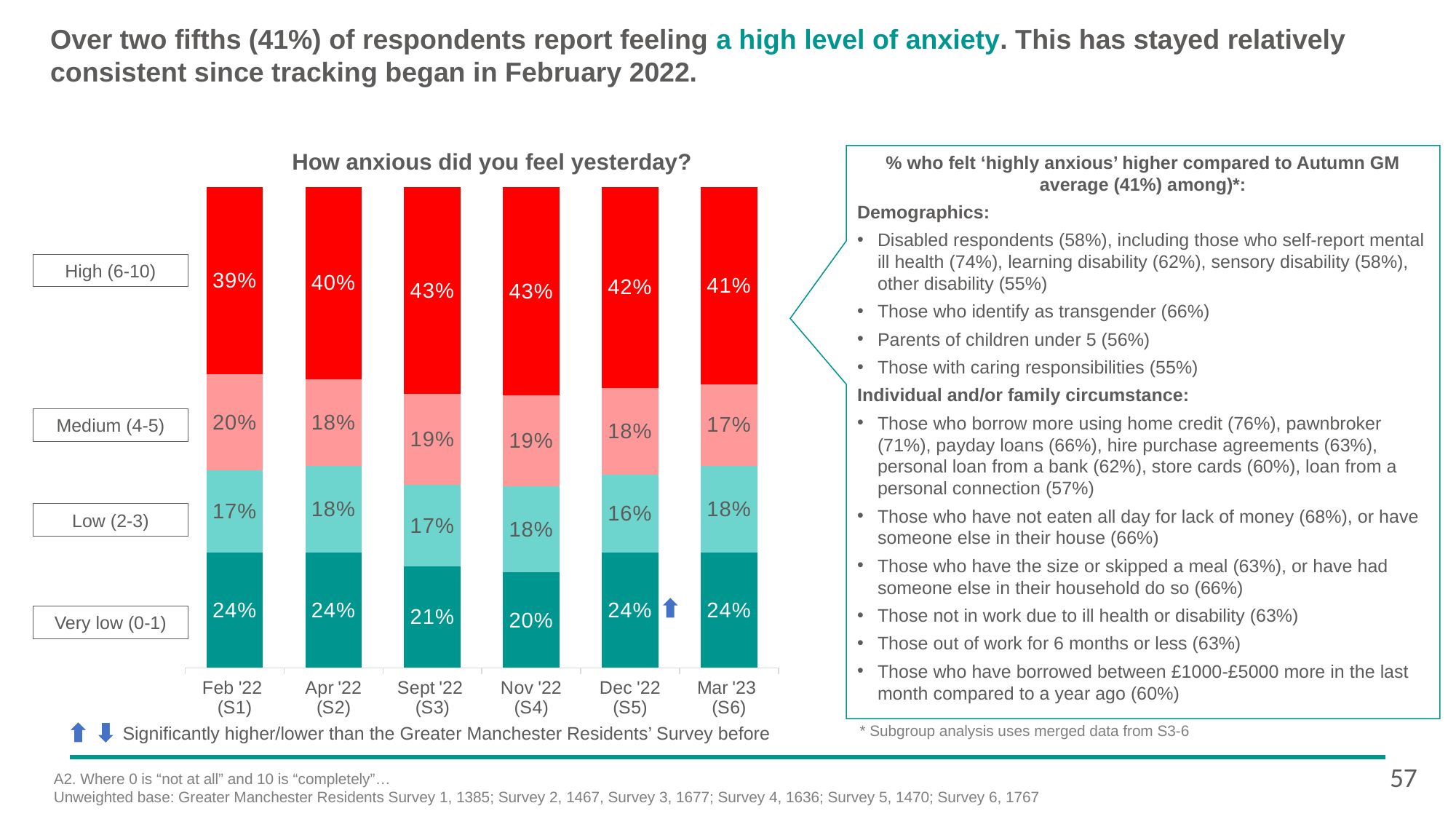
How many anxiety level categories (series) are stacked in each bar? 4 How many survey waves are shown on the x axis of the chart? 6 What type of chart is used to show how anxious respondents felt yesterday? Stacked bar chart What is the Medium (4-5) value for Feb '22 (S1)? 20% Which is larger: the Very low (0-1) value in Apr '22 (S2) or in Nov '22 (S4)? Apr '22 (S2) In which survey wave is the Very low (0-1) share the lowest? Nov '22 (S4) In which survey wave is the Medium (4-5) share the lowest? Mar '23 (S6) What percentage of respondents reported a High (6-10) level of anxiety in Mar '23 (S6)? 41% What is the difference between the High (6-10) value in Sept '22 (S3) and in Feb '22 (S1)? 4 percentage points What is the title of the chart? How anxious did you feel yesterday? What is the Very low (0-1) value for Sept '22 (S3)? 21% What is the Low (2-3) value for Dec '22 (S5)? 16%